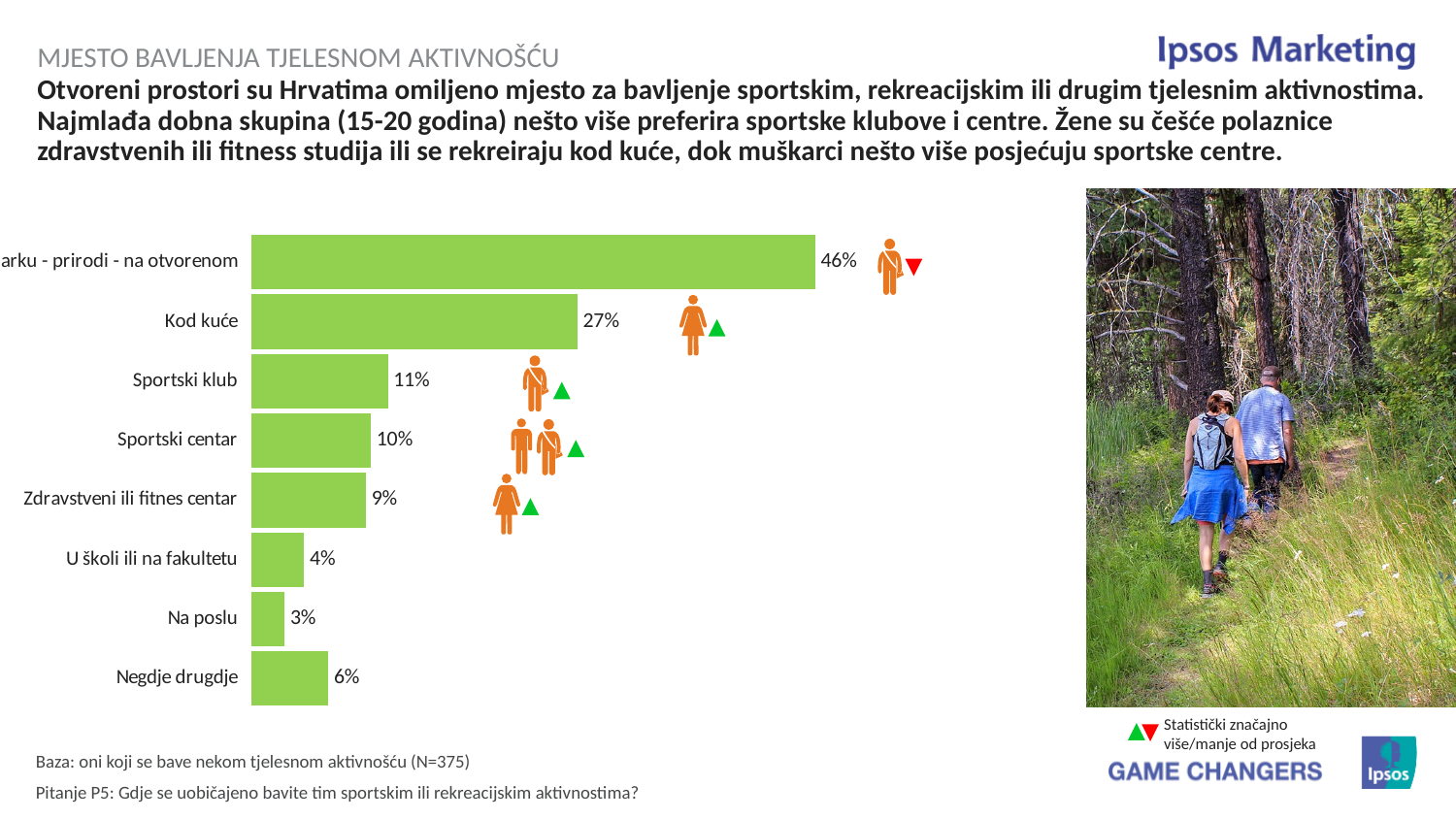
Which category has the lowest value? Na poslu Which is larger, the value for "Negdje drugdje" or for "U školi ili na fakultetu"? Negdje drugdje What is the value for "Sportski klub"? 11% What percentage is shown for "Kod kuće"? 27% How many categories are shown in the chart? 8 What is the difference between the values for "Kod kuće" and "Sportski klub"? 16 percentage points What is the value of the highest bar in the chart? 46% What percentage is shown for "Sportski centar"? 10% What percentage is shown for "Na poslu"? 3% What is the value for "Zdravstveni ili fitnes centar"? 9% What is the value for "Negdje drugdje"? 6% What type of chart is shown on the slide? Bar chart